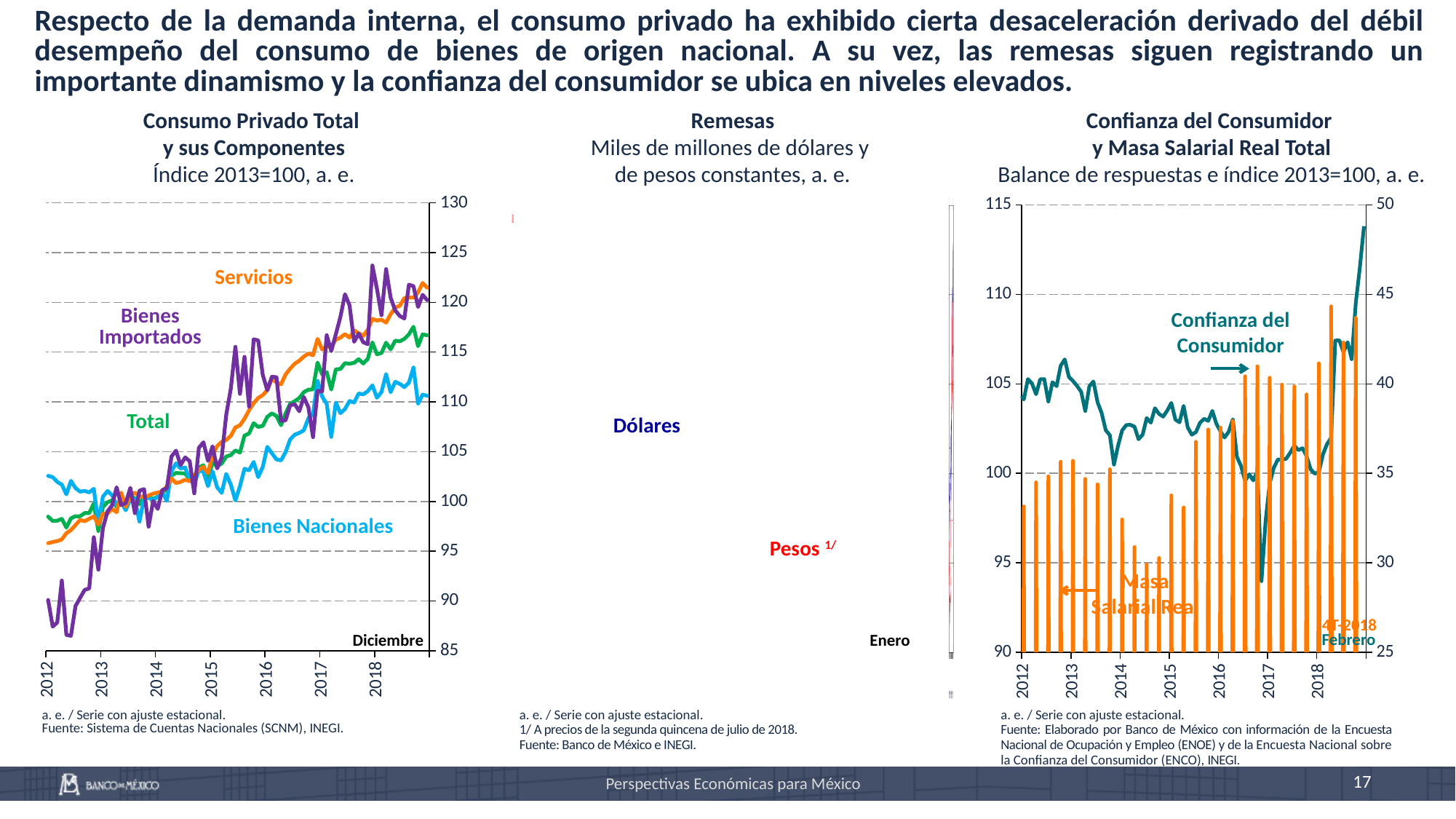
What kind of chart is the 'Consumo Privado Total y sus Componentes' chart? line chart In the 'Consumo Privado Total y sus Componentes' chart, which series has the lowest value at the end of the period (Diciembre 2018)? Bienes Nacionales In the 'Consumo Privado Total y sus Componentes' chart, is the value of Bienes Nacionales at the end of 2018 greater or less than 115? less In the 'Consumo Privado Total y sus Componentes' chart, which series has the lowest value at the start of 2012? Bienes Importados In the 'Confianza del Consumidor y Masa Salarial Real Total' chart, is the lowest point of Confianza del Consumidor around early 2017 greater or less than 35 on the right axis? less In the 'Confianza del Consumidor y Masa Salarial Real Total' chart, which series is plotted as bars? Masa Salarial Real What is the title of the middle chart on the slide? Remesas In the 'Consumo Privado Total y sus Componentes' chart, does the Total series rise or fall from 2012 to 2018? rise In the 'Consumo Privado Total y sus Componentes' chart, is the value of Servicios at the end of 2018 greater or less than 115? greater How many series are plotted in the 'Consumo Privado Total y sus Componentes' chart? 4 What is the highest value shown on the y axis of the 'Consumo Privado Total y sus Componentes' chart? 130